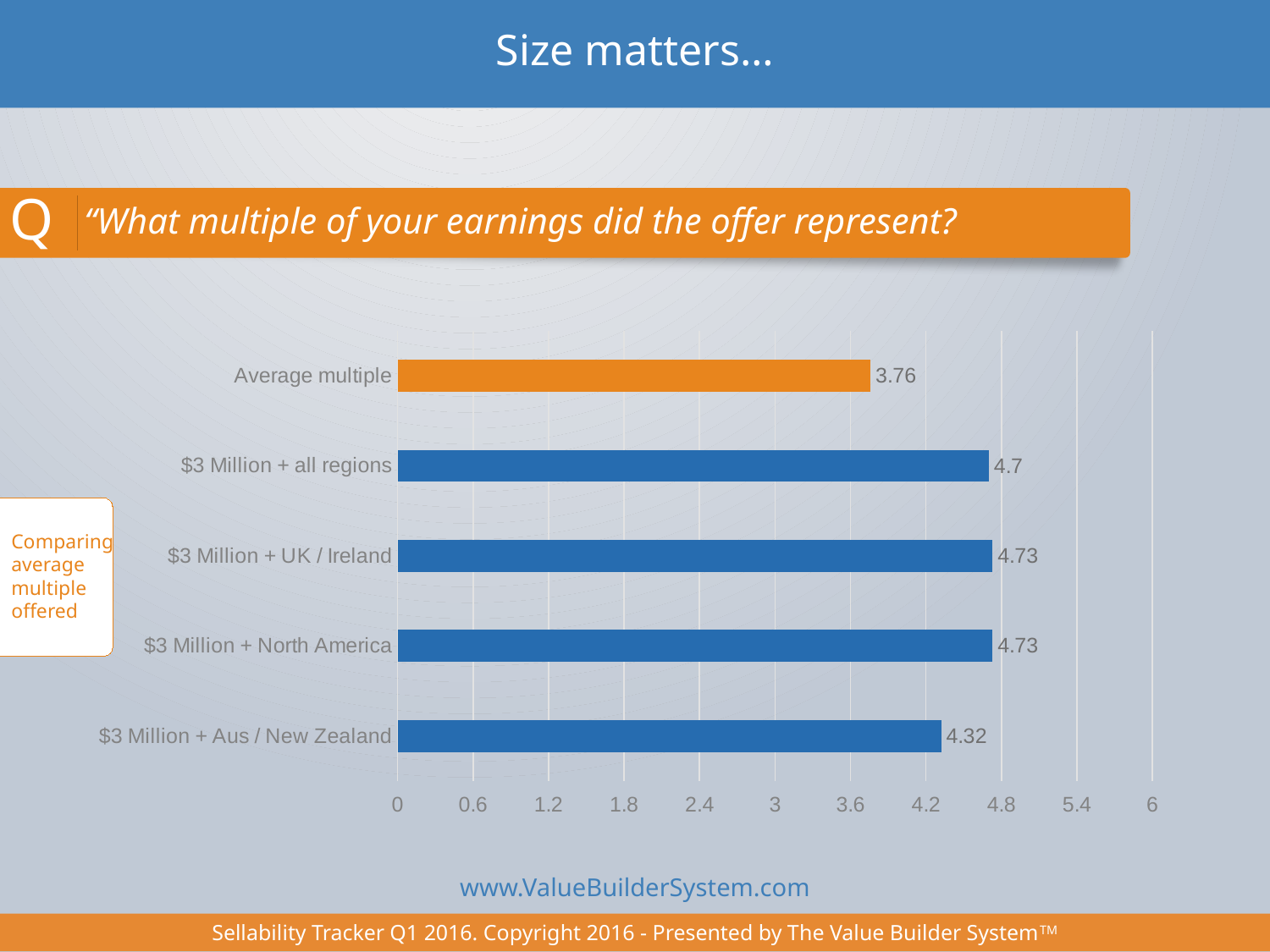
What is the value for $3 Million + North America? 4.73 What is the difference between the value for $3 Million + all regions and the value for $3 Million + Aus / New Zealand? 0.38 What is the value for Average multiple? 3.76 How many categories are shown in the chart? 5 Which category has the lowest value? Average multiple Which is larger, the value for $3 Million + Aus / New Zealand or the value for Average multiple? $3 Million + Aus / New Zealand What is the value for $3 Million + all regions? 4.7 Is the value for $3 Million + North America greater or less than 4.2? greater What is the difference between the value for $3 Million + UK / Ireland and the value for Average multiple? 0.97 What is the value for $3 Million + Aus / New Zealand? 4.32 Which bar is coloured orange rather than blue? Average multiple What kind of chart is shown on the slide? bar chart